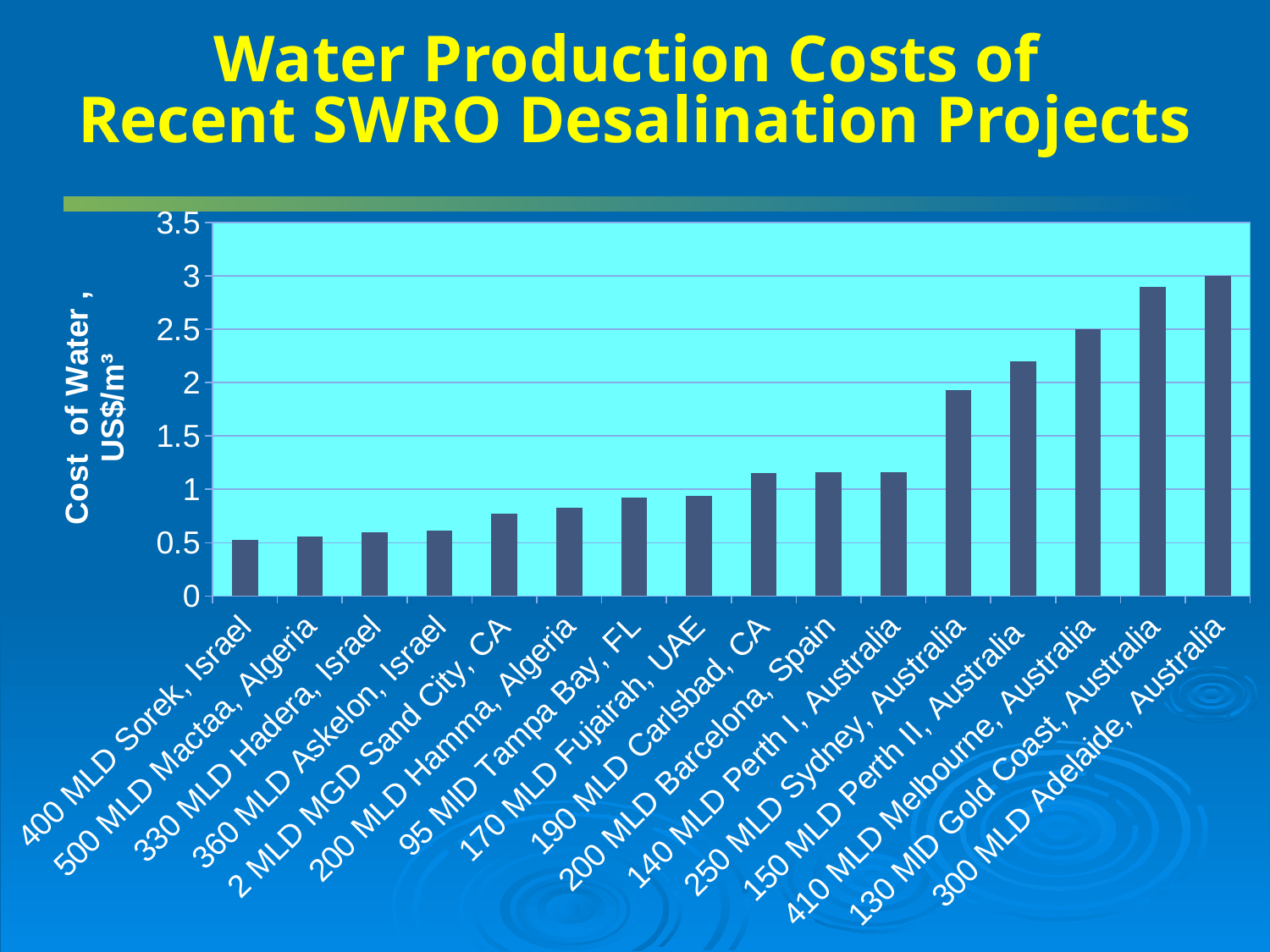
Is the value for 130 MID Gold Coast, Australia greater or less than 2.5? greater Which has a higher cost of water: 410 MLD Melbourne, Australia or 150 MLD Perth II, Australia? 410 MLD Melbourne, Australia Is the value for 150 MLD Perth II, Australia greater or less than 2? greater Which project has the highest cost of water? 300 MLD Adelaide, Australia Is the value for 250 MLD Sydney, Australia greater or less than 1.5? greater What kind of chart is shown on the slide? bar chart How many desalination projects are plotted on the chart? 16 Do the bar values generally rise or fall from left to right along the x axis? rise What is the cost of water for 300 MLD Adelaide, Australia? 3 What is the label on the vertical axis of the chart? Cost of Water, US$/m³ Which has a higher cost of water: 250 MLD Sydney, Australia or 190 MLD Carlsbad, CA? 250 MLD Sydney, Australia